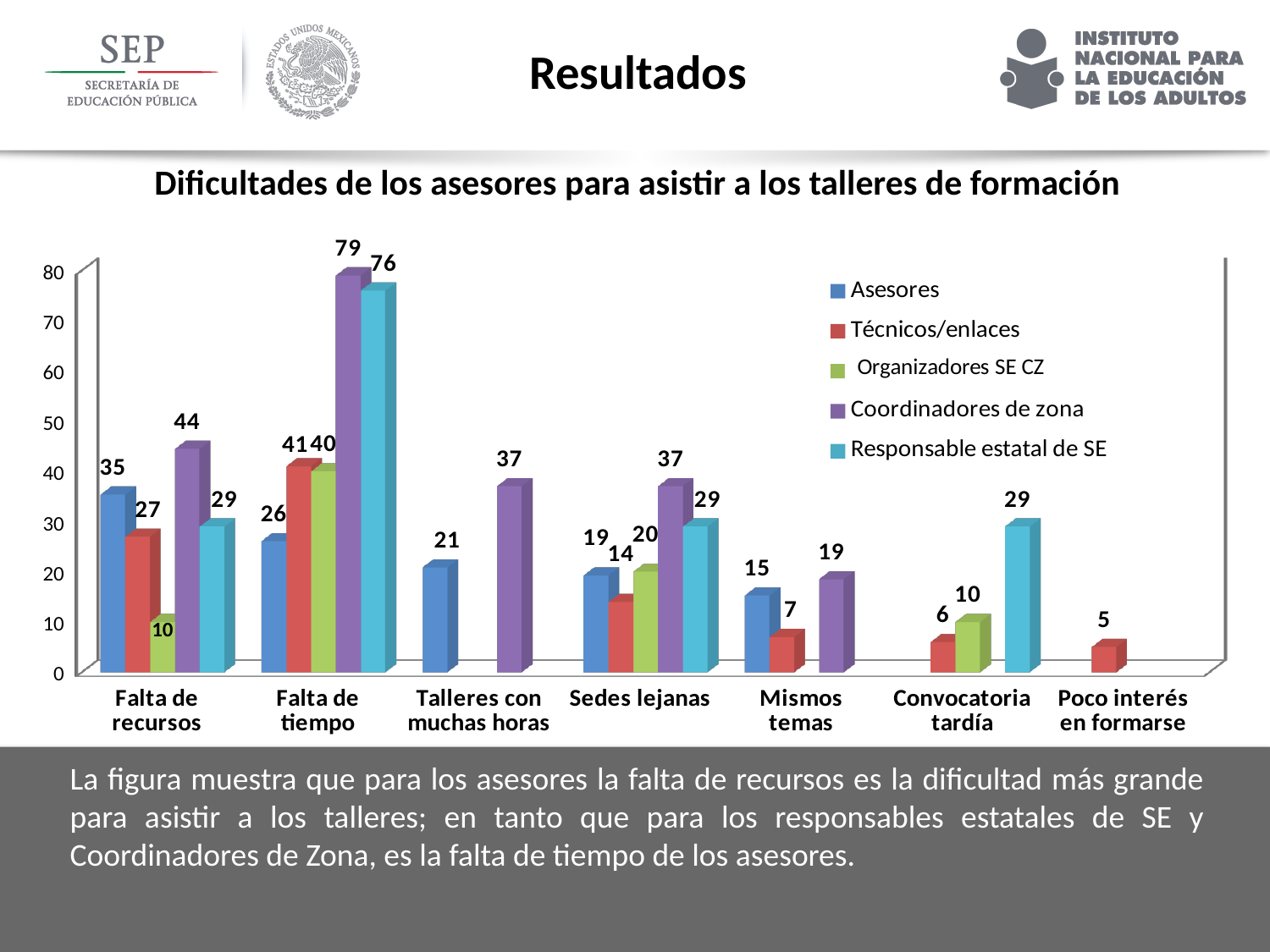
What is the value for Coordinadores de zona in the Falta de tiempo category? 79 What is the difference between the Coordinadores de zona and Responsable estatal de SE values in the Falta de tiempo category? 3 What is the value for Responsable estatal de SE in the Convocatoria tardía category? 29 How many series does the legend list? 5 What is the value for Asesores in the Falta de recursos category? 35 In the Sedes lejanas category, which is larger: the value for Técnicos/enlaces or the value for Organizadores SE CZ? Organizadores SE CZ Which category has the highest value for Coordinadores de zona? Falta de tiempo What is the value for Técnicos/enlaces in the Poco interés en formarse category? 5 What type of chart is shown on the slide? bar chart Which category has the lowest value for Asesores? Mismos temas What is the title of the chart? Dificultades de los asesores para asistir a los talleres de formación How many categories are shown on the x axis? 7